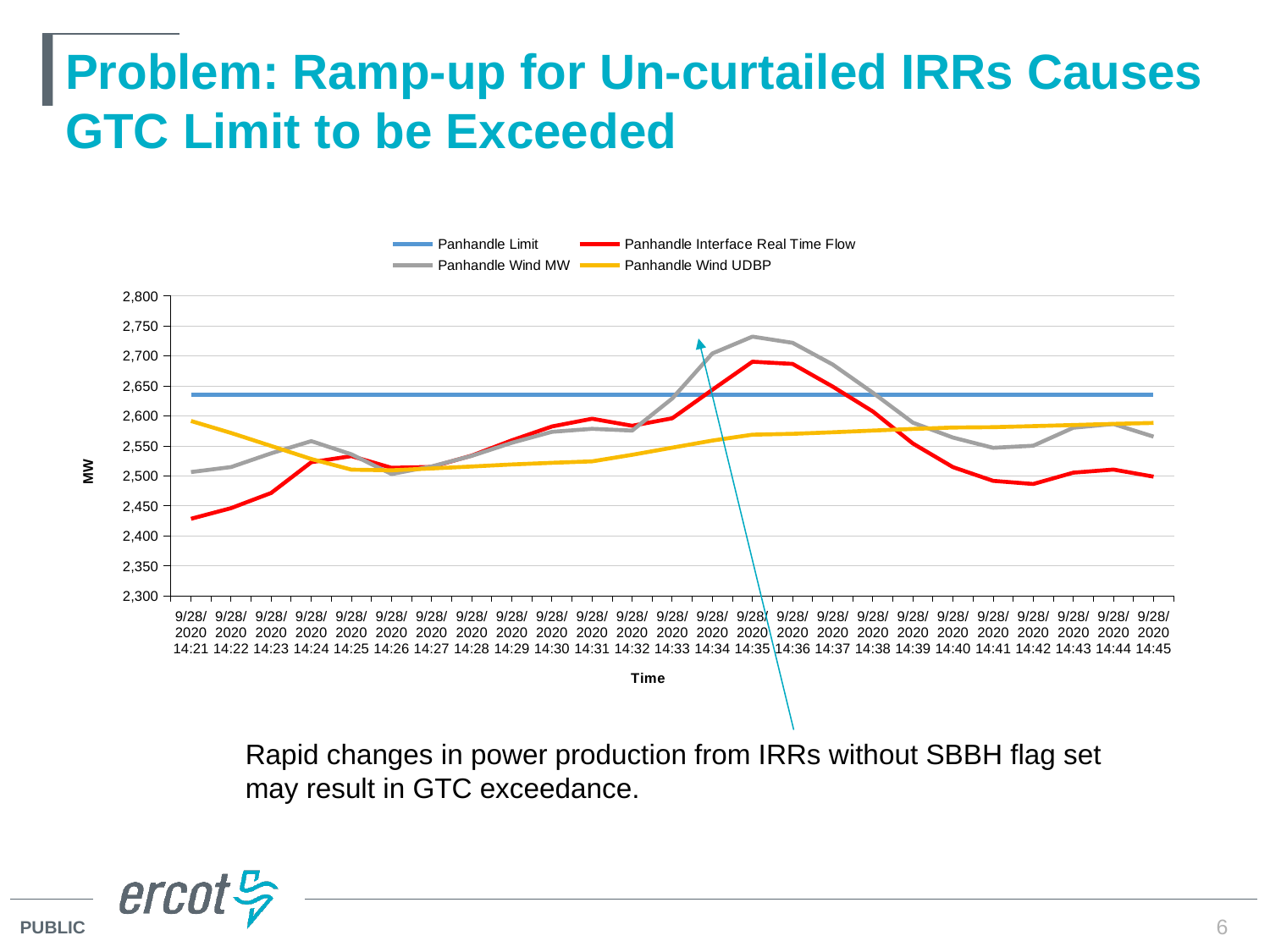
Is the Panhandle Limit line greater or less than 2,600? greater Does the Panhandle Wind UDBP series rise or fall between 9/28/2020 14:21 and 9/28/2020 14:25? fall At 9/28/2020 14:35, which is higher: Panhandle Wind MW or Panhandle Interface Real Time Flow? Panhandle Wind MW Is the value of Panhandle Wind MW at 9/28/2020 14:35 greater or less than 2,700? greater What kind of chart is shown on the slide? line chart At which time does the Panhandle Interface Real Time Flow series reach its highest value? 9/28/2020 14:35 What is the label of the y axis of the chart? MW Is the value of Panhandle Interface Real Time Flow at 9/28/2020 14:21 greater or less than 2,500? less At which time is the Panhandle Interface Real Time Flow series at its lowest value? 9/28/2020 14:21 Which series in the chart is drawn in red? Panhandle Interface Real Time Flow How many time points are shown along the x axis of the chart? 25 How many series does the chart legend list? 4